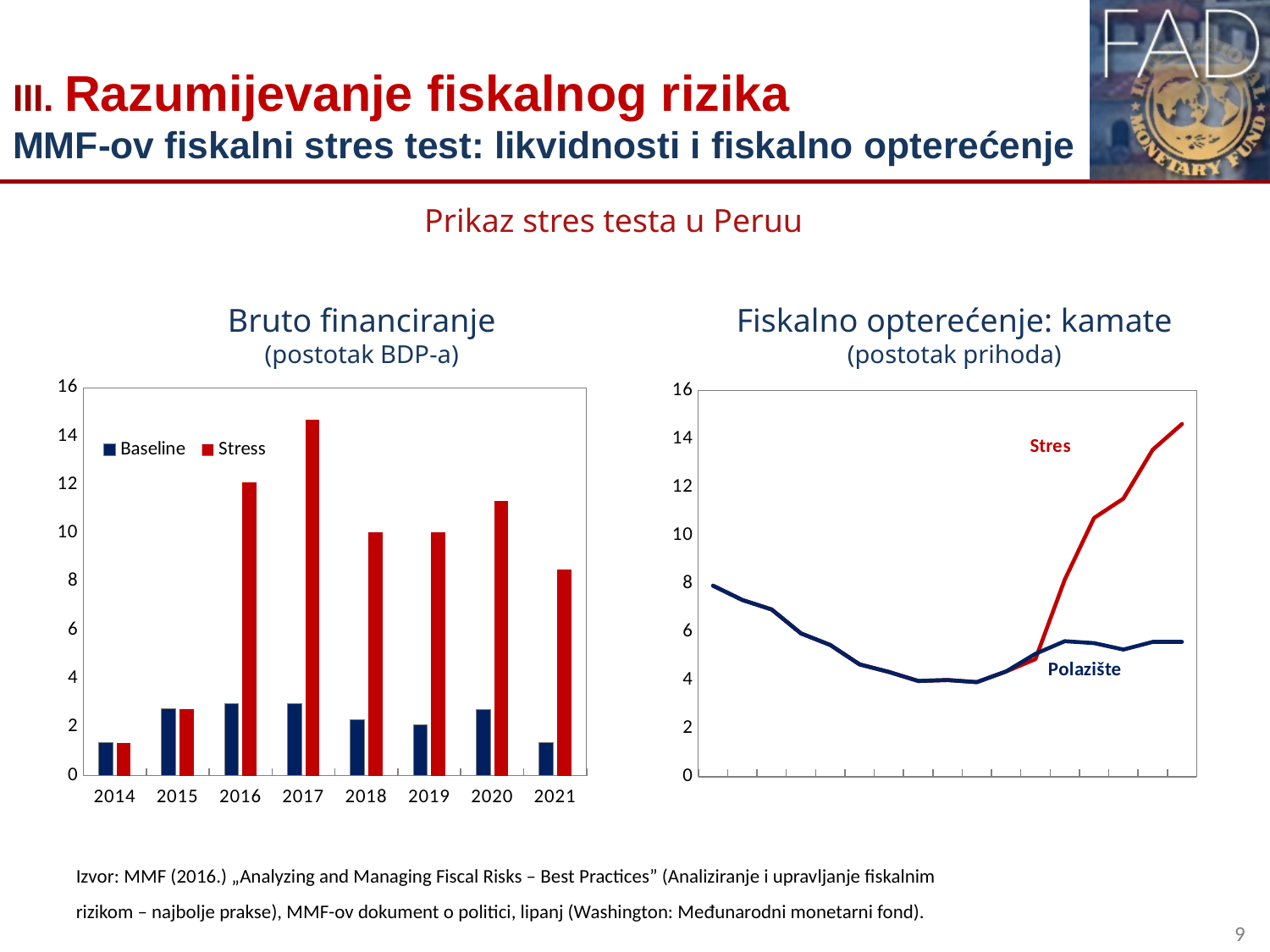
In the 'Fiskalno opterećenje: kamate' chart, is the final value of the Stres line greater or less than 14? greater What kind of chart is the 'Fiskalno opterećenje: kamate' chart on the right? line chart In the 'Bruto financiranje' chart, is the Baseline value for 2015 greater or less than 4? less In the 'Bruto financiranje' chart, which year has the lowest Stress value? 2014 In the 'Bruto financiranje' chart, which year has the highest Stress value? 2017 In the 'Bruto financiranje' chart, how many series does the legend list? 2 In the 'Bruto financiranje' chart, which is larger, the Stress value for 2016 or the Stress value for 2021? 2016 In the 'Fiskalno opterećenje: kamate' chart, which line is higher at the right end, Stres or Polazište? Stres What kind of chart is the 'Bruto financiranje' chart on the left? bar chart In the 'Bruto financiranje' chart, how many years are shown on the x axis? 8 In the 'Fiskalno opterećenje: kamate' chart, what colour is the Stres line? red In the 'Bruto financiranje' chart, is the Stress value for 2017 greater or less than 14? greater